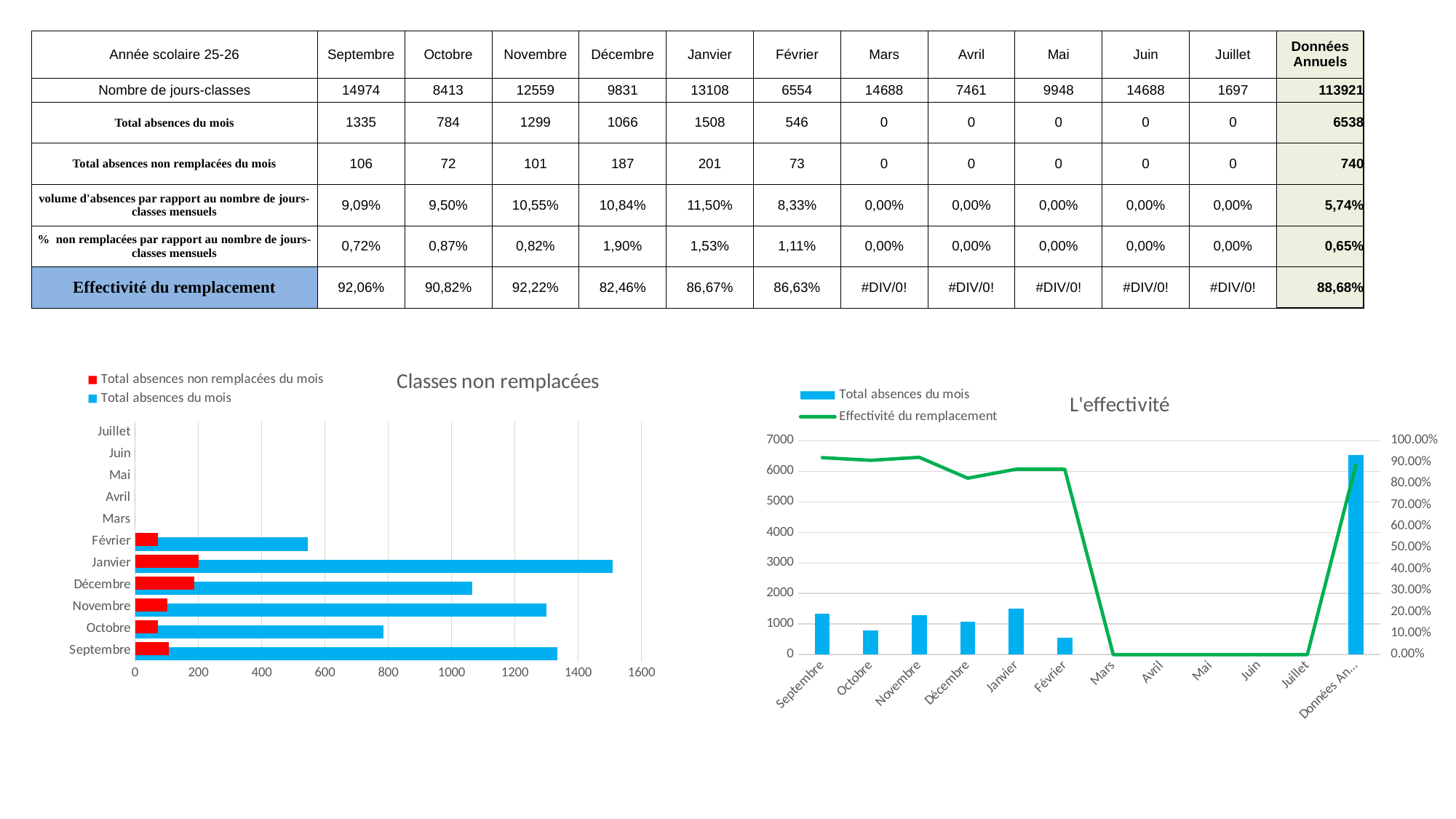
How many series does the legend of the 'L'effectivité' chart list? 2 In the 'Classes non remplacées' chart, which is larger: 'Total absences du mois' for Novembre or for Décembre? Novembre How many categories are shown on the x axis of the 'L'effectivité' chart? 12 In the 'Classes non remplacées' chart, which month has the highest 'Total absences du mois' bar? Janvier How many month categories are shown on the y axis of the 'Classes non remplacées' chart? 11 In the 'Classes non remplacées' chart, is the 'Total absences du mois' value for Février greater or less than 600? less In the 'Classes non remplacées' chart, is the 'Total absences du mois' value for Janvier greater or less than 1400? greater In the 'L'effectivité' chart, does the 'Effectivité du remplacement' line rise or fall from Février to Mars? fall What kind of chart is the 'Classes non remplacées' chart? bar chart How many series does the legend of the 'Classes non remplacées' chart list? 2 In the 'Classes non remplacées' chart, which colour represents 'Total absences non remplacées du mois'? red In the 'L'effectivité' chart, is the 'Total absences du mois' bar for 'Données An...' greater or less than 6000? greater